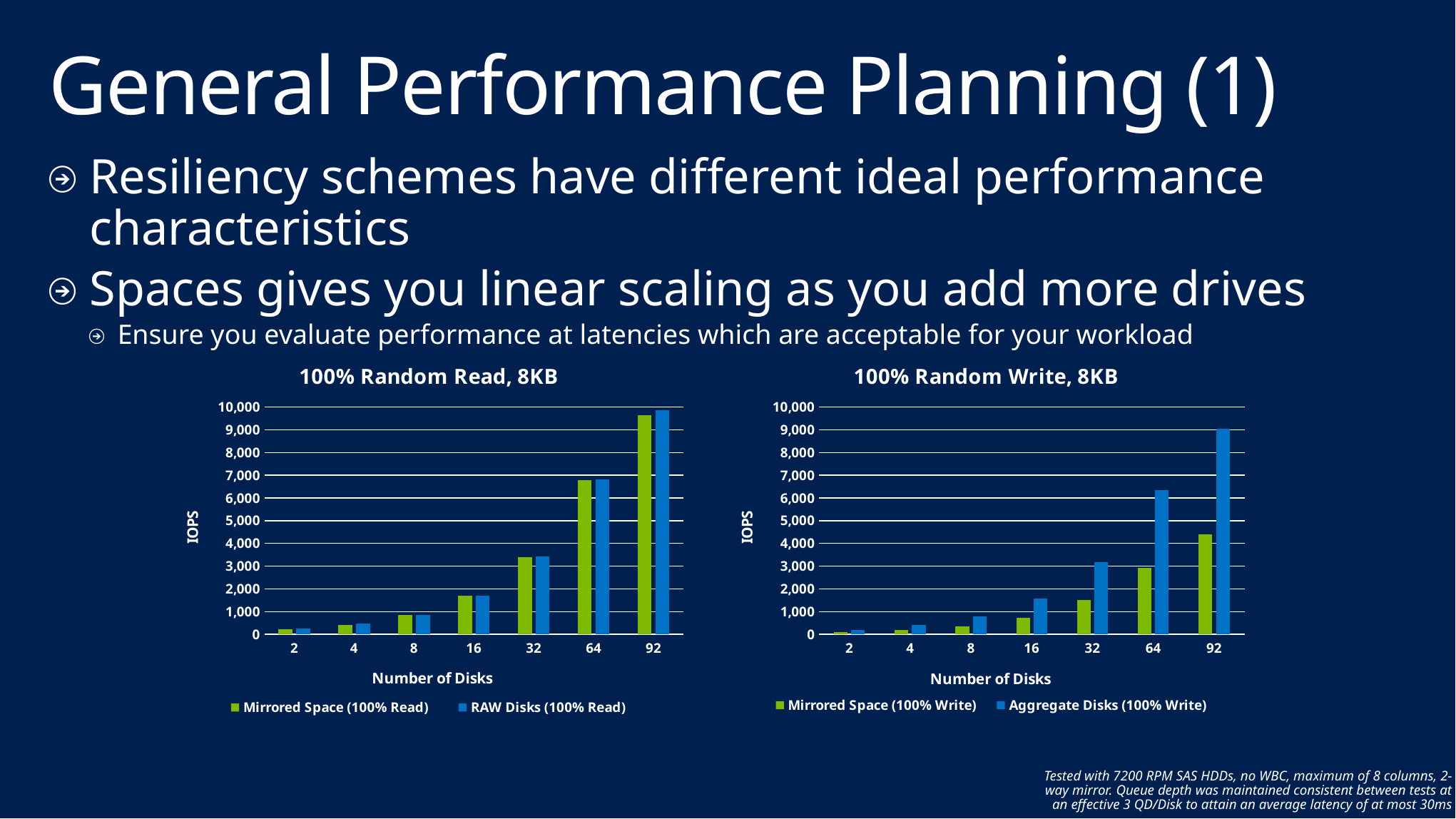
What are the two legend entries of the "100% Random Write, 8KB" chart? Mirrored Space (100% Write) and Aggregate Disks (100% Write) In the "100% Random Read, 8KB" chart, do the RAW Disks (100% Read) values rise or fall as the Number of Disks increases? rise In the "100% Random Read, 8KB" chart, is the Mirrored Space (100% Read) value at 64 disks greater or less than 6,000? greater In the "100% Random Write, 8KB" chart, is the Mirrored Space (100% Write) value at 92 disks greater or less than 5,000? less In the "100% Random Read, 8KB" chart, which Number of Disks has the lowest Mirrored Space (100% Read) value? 2 In the "100% Random Write, 8KB" chart, at 64 disks, which series is larger: Mirrored Space (100% Write) or Aggregate Disks (100% Write)? Aggregate Disks (100% Write) How many Number of Disks categories are shown on the x axis of the "100% Random Write, 8KB" chart? 7 In the "100% Random Write, 8KB" chart, at 92 disks, which series is larger: Mirrored Space (100% Write) or Aggregate Disks (100% Write)? Aggregate Disks (100% Write) In the "100% Random Write, 8KB" chart, which Number of Disks has the highest Aggregate Disks (100% Write) value? 92 What kind of chart is the "100% Random Read, 8KB" chart? bar chart What is the y-axis label of the "100% Random Write, 8KB" chart? IOPS How many series does the legend of the "100% Random Read, 8KB" chart list? 2